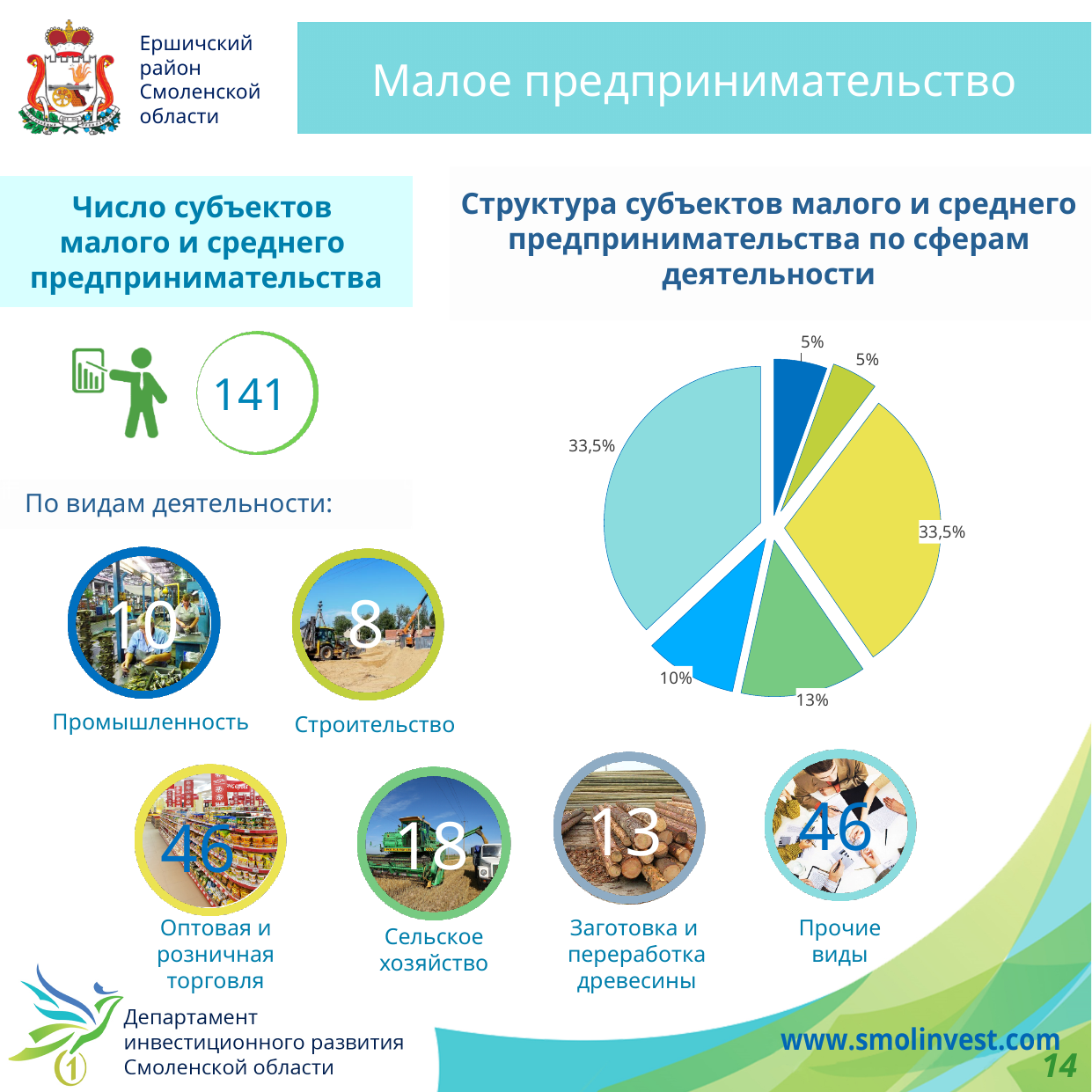
What is the title of the pie chart? Структура субъектов малого и среднего предпринимательства по сферам деятельности How many slices of the pie chart are labeled 5%? 2 How many slices does the pie chart have? 6 How many slices of the pie chart are labeled 33,5%? 2 What kind of chart is shown on the right side of the slide? Pie chart Is the share of the slice labeled 13% on the pie chart greater or less than 10%? greater What is the largest percentage shown on the pie chart? 33,5% What is the combined share of the two slices labeled 33,5% on the pie chart? 67% Does the pie chart include a legend? No Which is larger on the pie chart: the green slice labeled 13% or the blue slice labeled 10%? The green slice labeled 13% What is the smallest percentage shown on the pie chart? 5% What is the difference between the slice labeled 13% and the slice labeled 10% on the pie chart? 3%